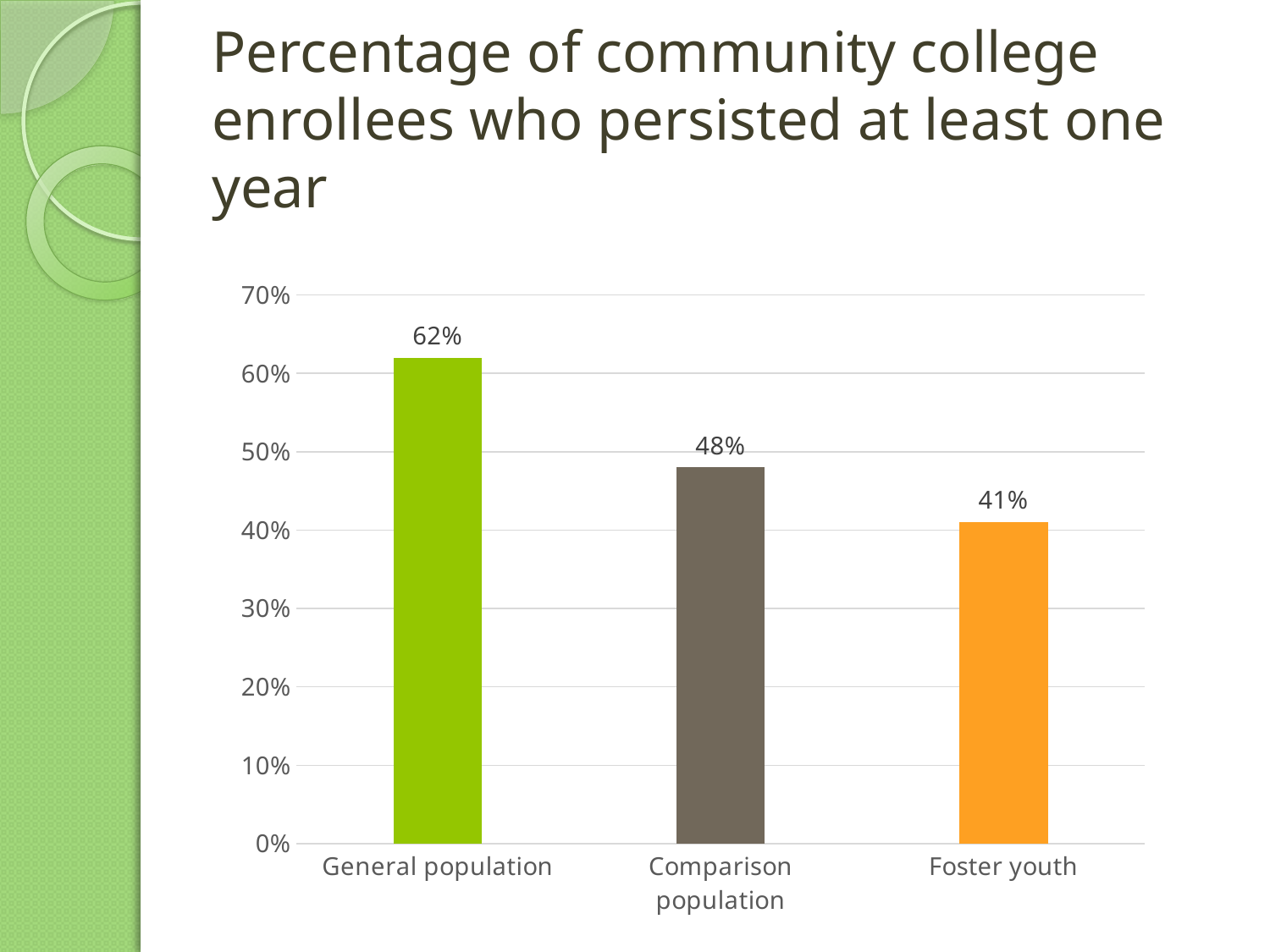
What is the value for Comparison population? 48% Which category has the highest value? General population What is the value for General population? 62% Which is larger, the value for Comparison population or the value for Foster youth? Comparison population What kind of chart is shown on the slide? bar chart Do the values rise or fall from left to right across the categories? fall How many categories are shown on the chart? 3 What is the difference between the values for Comparison population and Foster youth? 7% What is the difference between the values for General population and Foster youth? 21% Which category has the lowest value? Foster youth Is the value for Comparison population greater or less than 50%? less What is the value for Foster youth? 41%